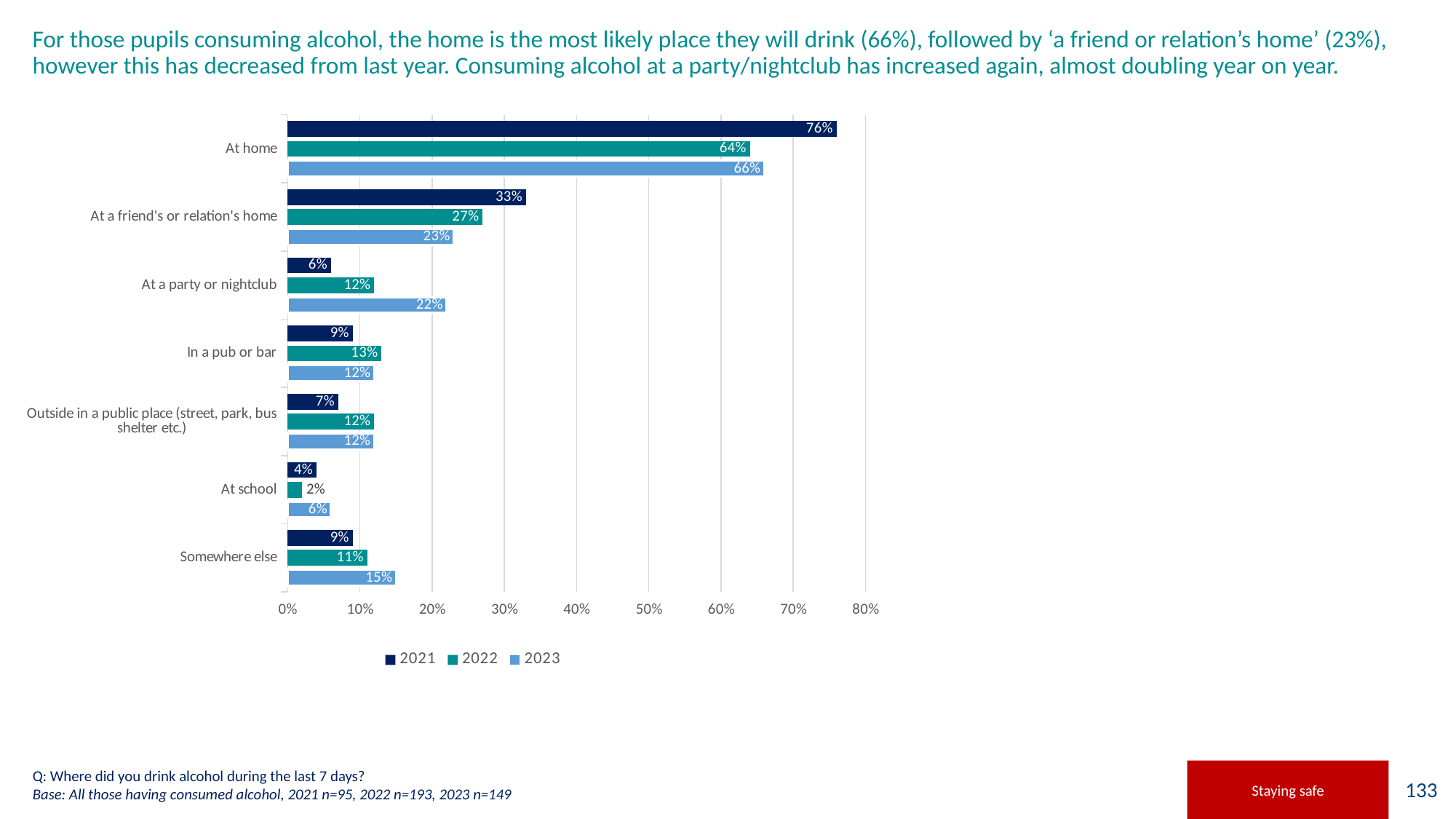
Which category has the highest 2023 value? At home What is the difference between the 2022 and 2023 values for 'At a party or nightclub'? 10% What kind of chart is shown on the slide? Bar chart What is the 2022 value for 'At school'? 2% What is the 2023 value for 'At home'? 66% What is the difference between the 2021 and 2023 values for 'At home'? 10% Which is larger: the 2023 value for 'At a party or nightclub' or the 2023 value for 'Somewhere else'? At a party or nightclub Which category has the lowest 2022 value? At school How many series does the legend list? 3 How many categories are shown on the chart? 7 Which years are listed in the chart legend? 2021, 2022, 2023 What is the 2021 value for 'At a friend's or relation's home'? 33%